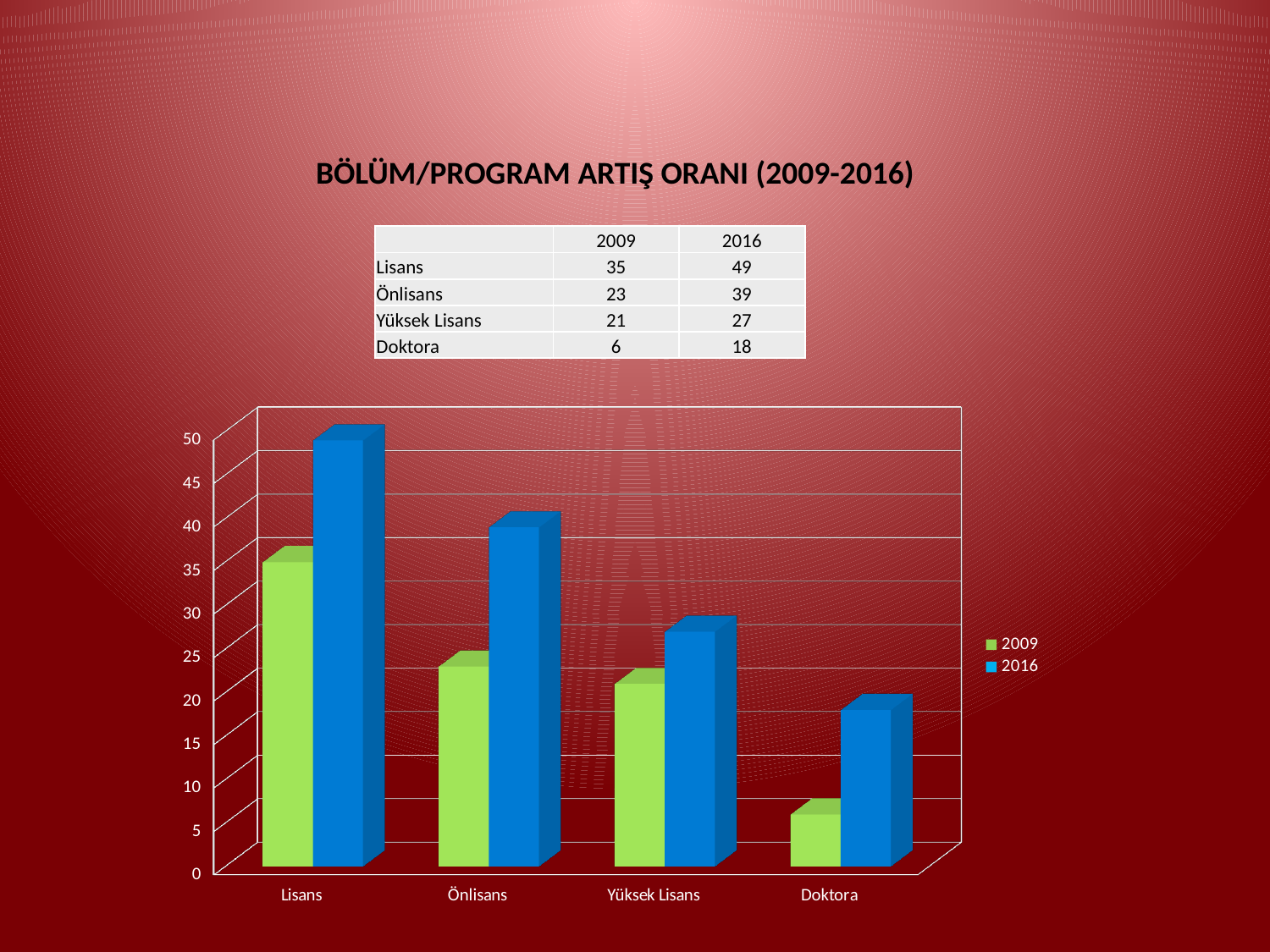
Which category has the lowest 2009 value? Doktora Which colour represents the 2016 series in the chart? blue How many series does the chart legend list? 2 What is the 2016 value for Lisans? 49 What is the difference between the 2016 and 2009 values for Önlisans? 16 What is the 2016 value for Önlisans? 39 Is the 2016 value for Doktora greater or less than 20? less How many categories are shown on the x axis of the chart? 4 What is the 2009 value for Doktora? 6 What type of chart is shown on the slide? bar chart Which category has the highest 2016 value? Lisans Which is larger, the 2009 value for Yüksek Lisans or the 2009 value for Önlisans? 2009 value for Önlisans